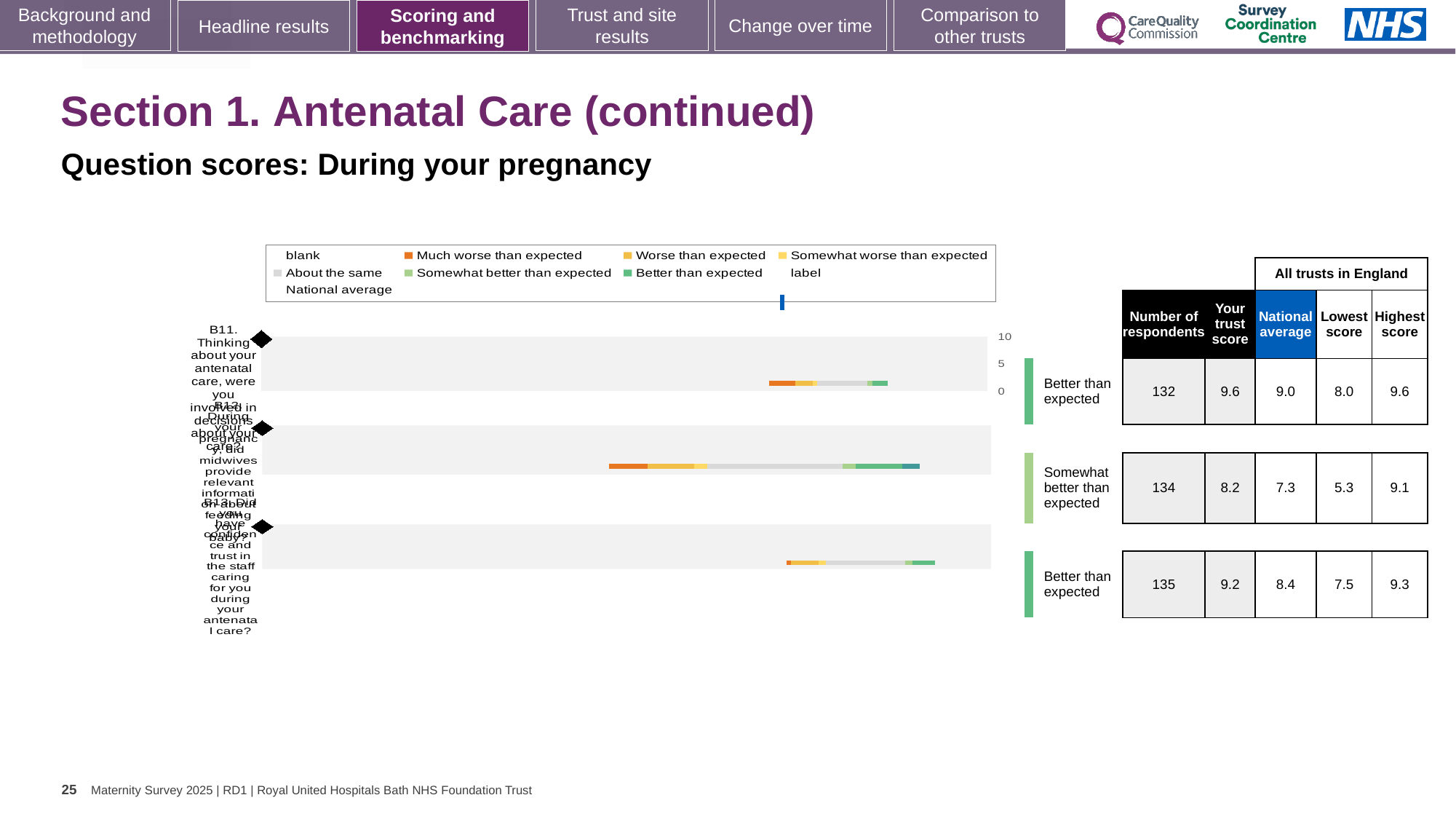
What is the highest value shown on the chart's axis? 10 How many entries does the chart legend list? 9 What is the difference between the 'Your trust score' and the national average for B13 in the table beside the chart? 0.8 Which legend entry is shown in orange in the chart? Much worse than expected Is the 'Your trust score' for B11 or for B12 larger in the table beside the chart? B11 Which of the three questions has the lowest 'Your trust score' in the table beside the chart? B12 In the table beside the chart, what is the national average for B12? 7.3 How many question categories (bars) are plotted in the chart? 3 What kind of chart is shown on the slide? bar chart In the table beside the chart, what is the 'Your trust score' for B11 (involved in decisions about your care)? 9.6 In the table beside the chart, what is the 'Your trust score' for B13 (confidence and trust in the staff caring for you)? 9.2 In the table beside the chart, what is the 'Your trust score' for B12 (midwives provide relevant information about feeding your baby)? 8.2